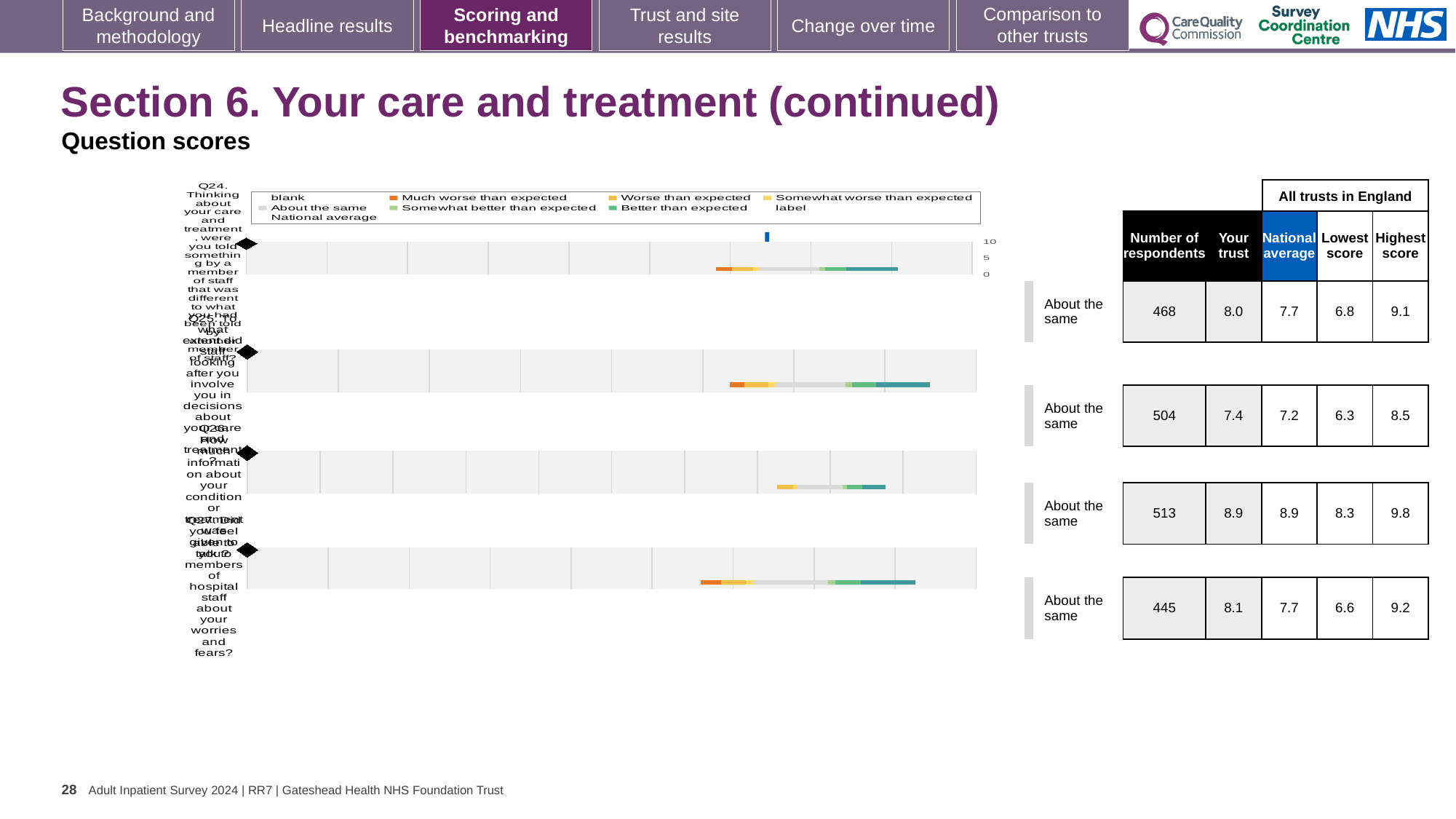
Which question chart has the highest 'Your trust' score? the third chart (8.9) For the first (top) question chart, what is the national average shown in the table? 7.7 For the third question chart, what is the highest score among all trusts in England? 9.8 Which question chart has the fewest respondents? the fourth (bottom) chart (445) For the first (top) question chart, what is the 'Your trust' score shown in the table? 8.0 For the second question chart, which is larger: the 'Your trust' score or the national average? Your trust What kind of chart is used for the question scores on this slide? bar chart For the fourth (bottom) question chart, what is the lowest score among all trusts in England? 6.6 How many question score charts are shown on the slide? 4 For the first (top) question chart, what is the difference between the 'Your trust' score and the national average? 0.3 In the chart legend, what colour represents 'Much worse than expected'? orange For the second question chart, how many respondents are shown in the table? 504